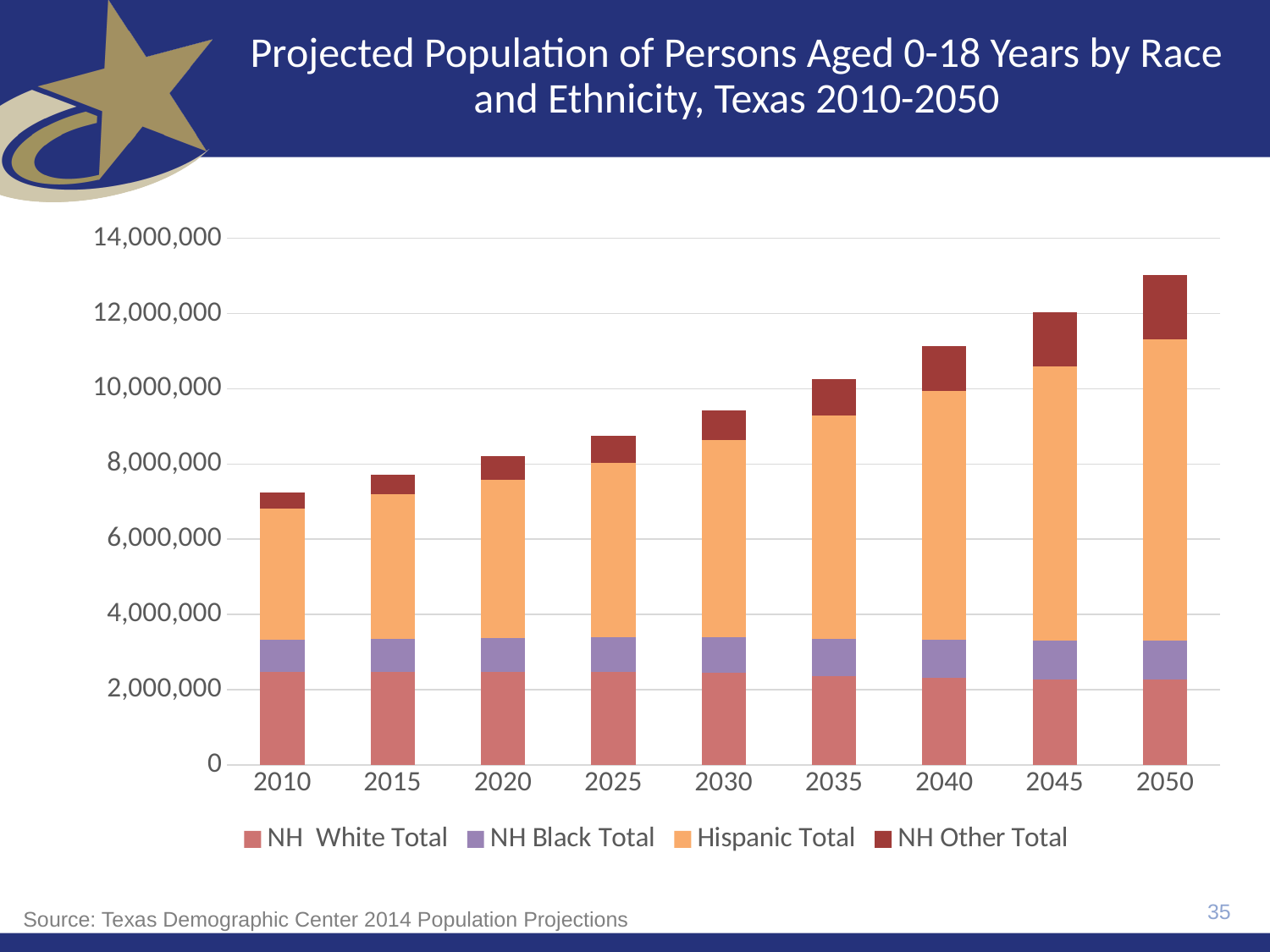
Is the total bar for 2010 greater or less than 8,000,000? less Is the total bar for 2030 greater or less than 10,000,000? less Does the total projected population aged 0-18 rise or fall from 2010 to 2050? Rise What kind of chart is shown on the slide? Stacked bar chart Which is larger, the total bar for 2050 or the total bar for 2010? 2050 Which year has the lowest total projected population aged 0-18? 2010 Is the total bar for 2040 greater or less than 10,000,000? greater Which series is shown in orange in the chart? Hispanic Total How many series does the legend list? 4 Which year has the highest total projected population aged 0-18? 2050 How many years are shown along the x axis of the chart? 9